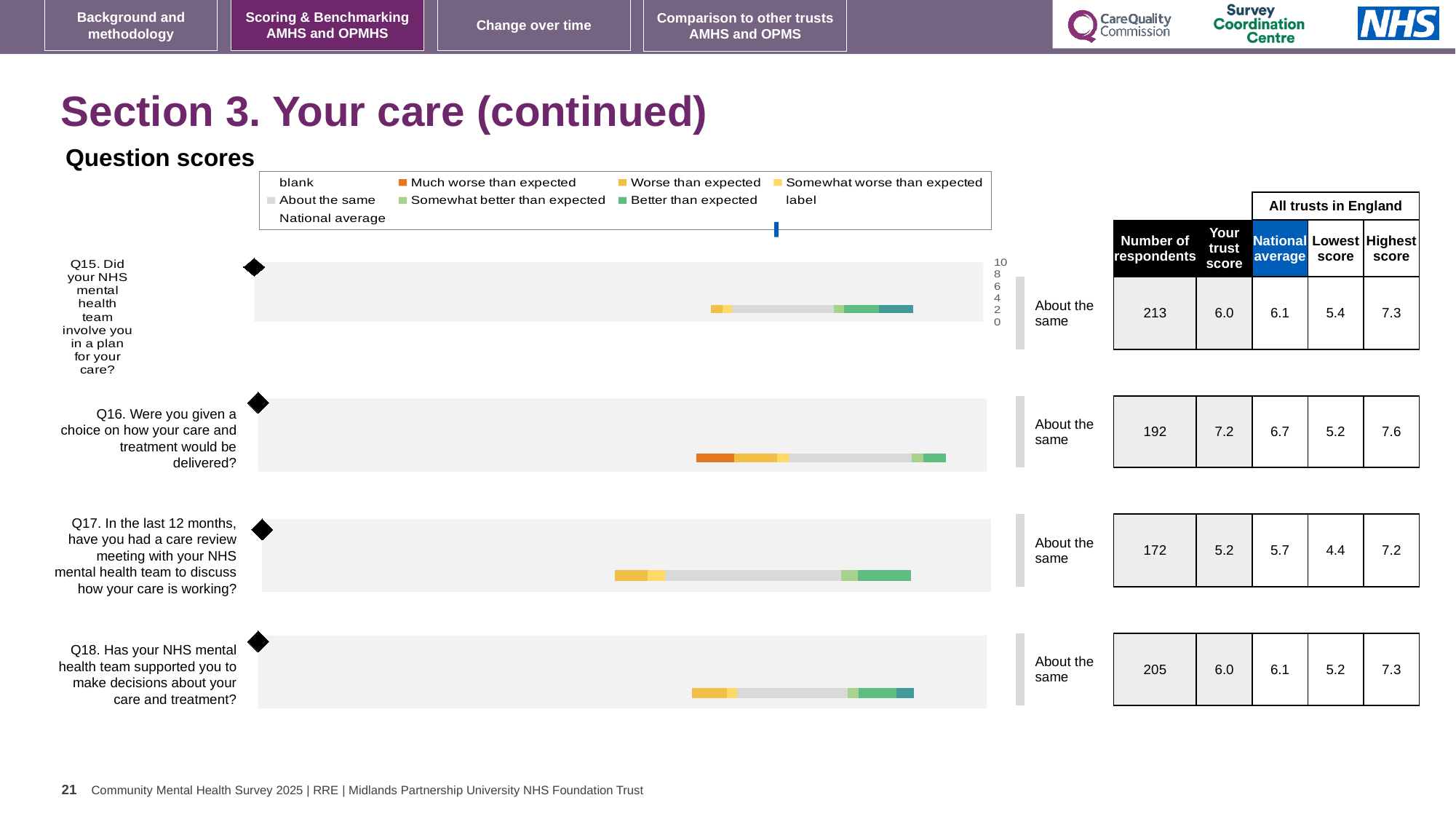
How many questions (Q15 to Q18) have a bar plotted on the slide? 4 What benchmark label is shown to the right of the Q17 bar? About the same In the table next to the charts, what is the highest score for Q15? 7.3 In the table next to the charts, how many respondents are listed for Q17? 172 In the table next to the charts, what is the national average for Q18? 6.1 In the table next to the charts, what is the 'Your trust score' for Q16? 7.2 What kind of chart is used to show the question scores for Q15 to Q18? bar chart What is the maximum value shown on the axis of the Q15 chart? 10 What is the difference between the highest score and the lowest score for Q16 in the table? 2.4 Which question has the highest number of respondents in the table? Q15 Which question has the lowest 'Your trust score' in the table? Q17 For Q16, which is larger: the trust score or the national average? Your trust score